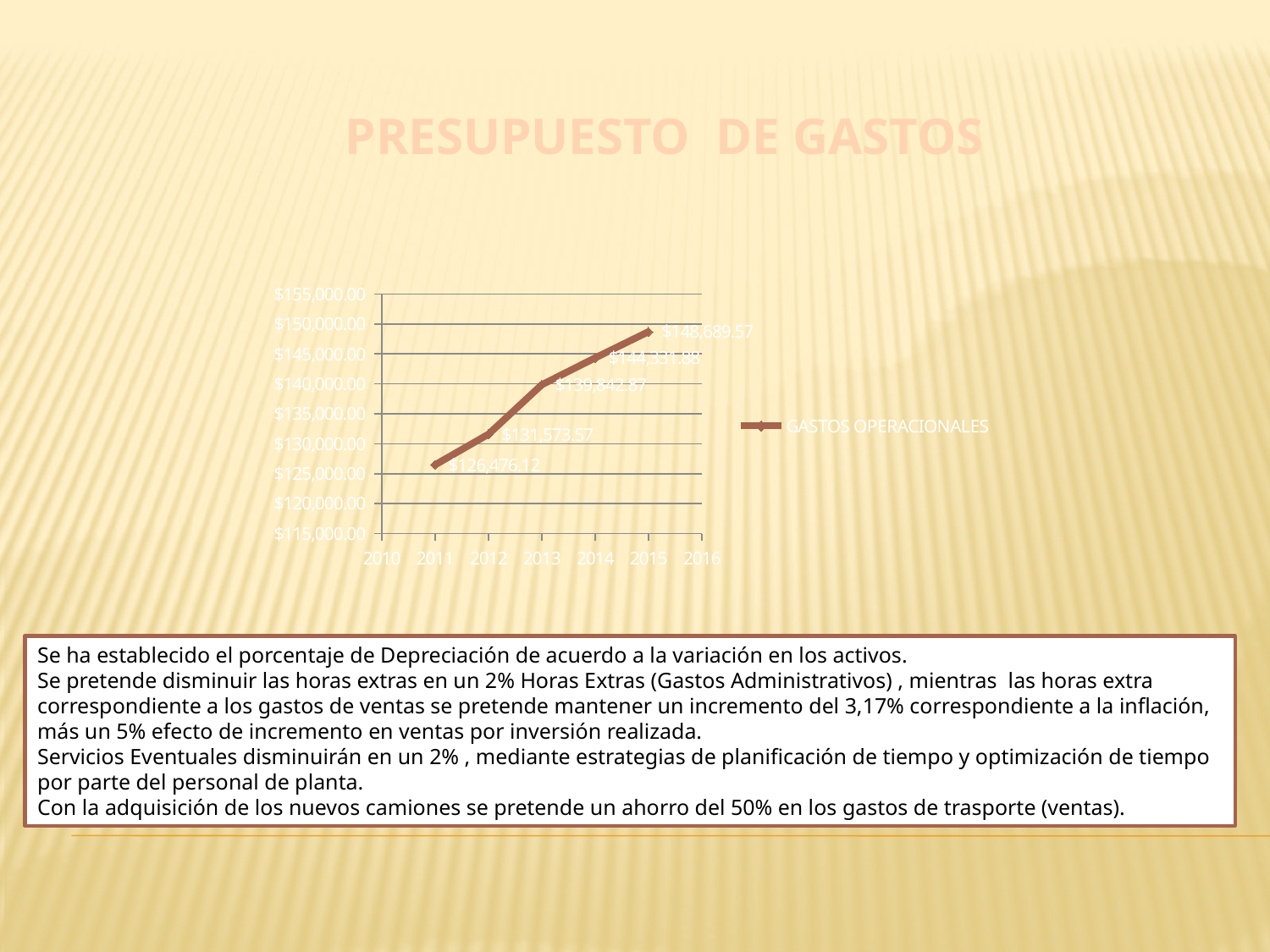
How many series does the legend list? 1 Is the value for 2013 greater or less than $135,000.00? greater Which year has the highest value of GASTOS OPERACIONALES? 2015 What is the name of the series shown in the legend? GASTOS OPERACIONALES Which year has the lowest value of GASTOS OPERACIONALES? 2011 What is the difference between the GASTOS OPERACIONALES values for 2015 and 2011? $22,213.45 How many data points are plotted on the line? 5 Do the values of GASTOS OPERACIONALES rise or fall from 2011 to 2015? Rise What is the value of GASTOS OPERACIONALES for 2011? $126,476.12 What kind of chart is shown on the slide? Line chart What is the value of GASTOS OPERACIONALES for 2012? $131,573.57 What is the value of GASTOS OPERACIONALES for 2015? $148,689.57